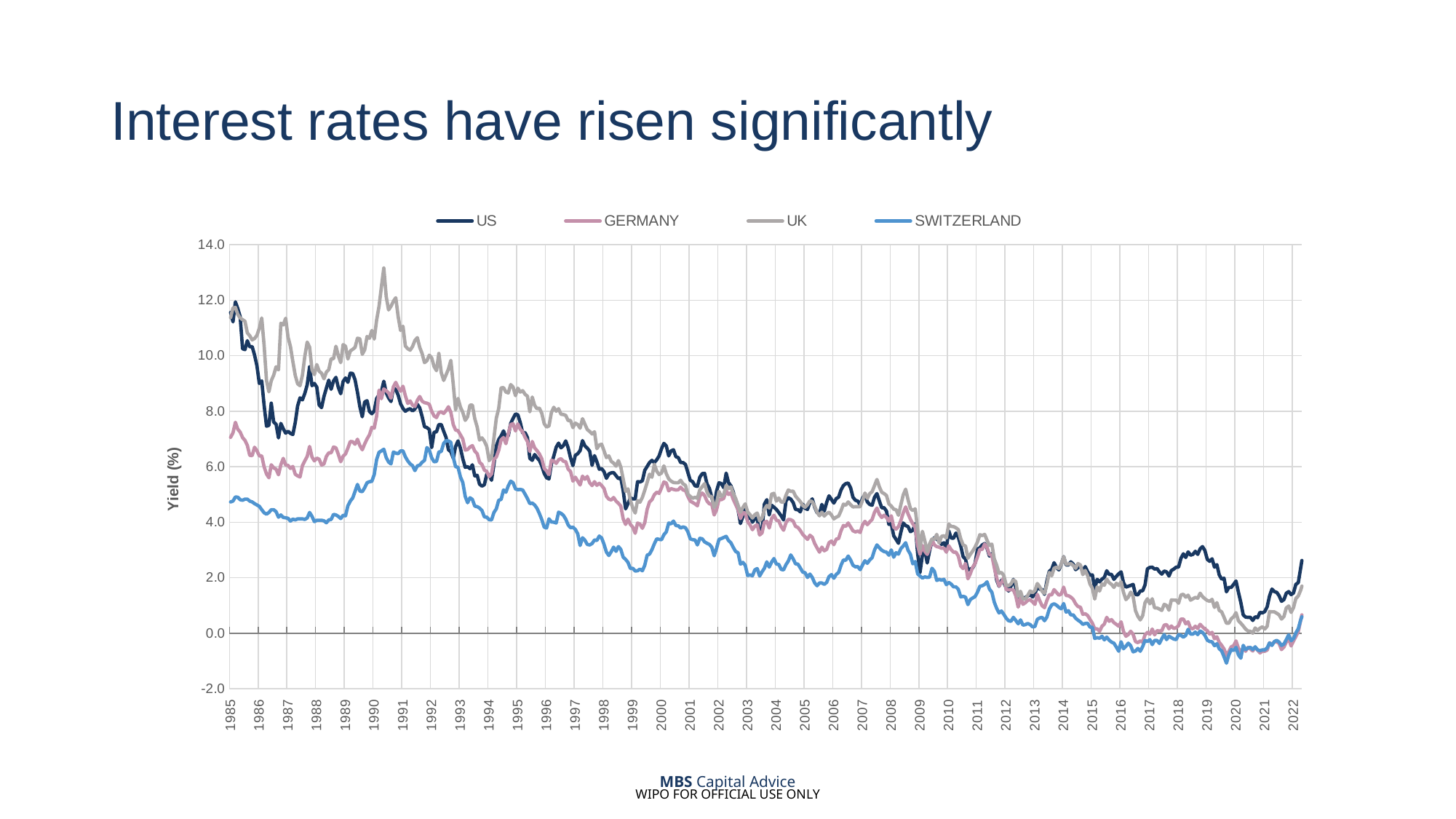
Around 2019, which is higher, US or UK? US What kind of chart is shown on the slide? line chart What is the title of the slide containing the chart? Interest rates have risen significantly Which series reaches the highest value anywhere on the chart? UK Is the peak value for UK around 1990 greater or less than 12.0? greater Do the yields generally rise or fall from 1985 to 2020? fall How many series does the legend list? 4 Which series is the lowest for most of the period shown? SWITZERLAND At the start of 1985, which is higher, UK or SWITZERLAND? UK Which series are listed in the legend? US, GERMANY, UK, SWITZERLAND Is the value for US at the end of the chart in 2022 greater or less than 2.0? greater Is the value for SWITZERLAND at the start of 1985 greater or less than 6.0? less